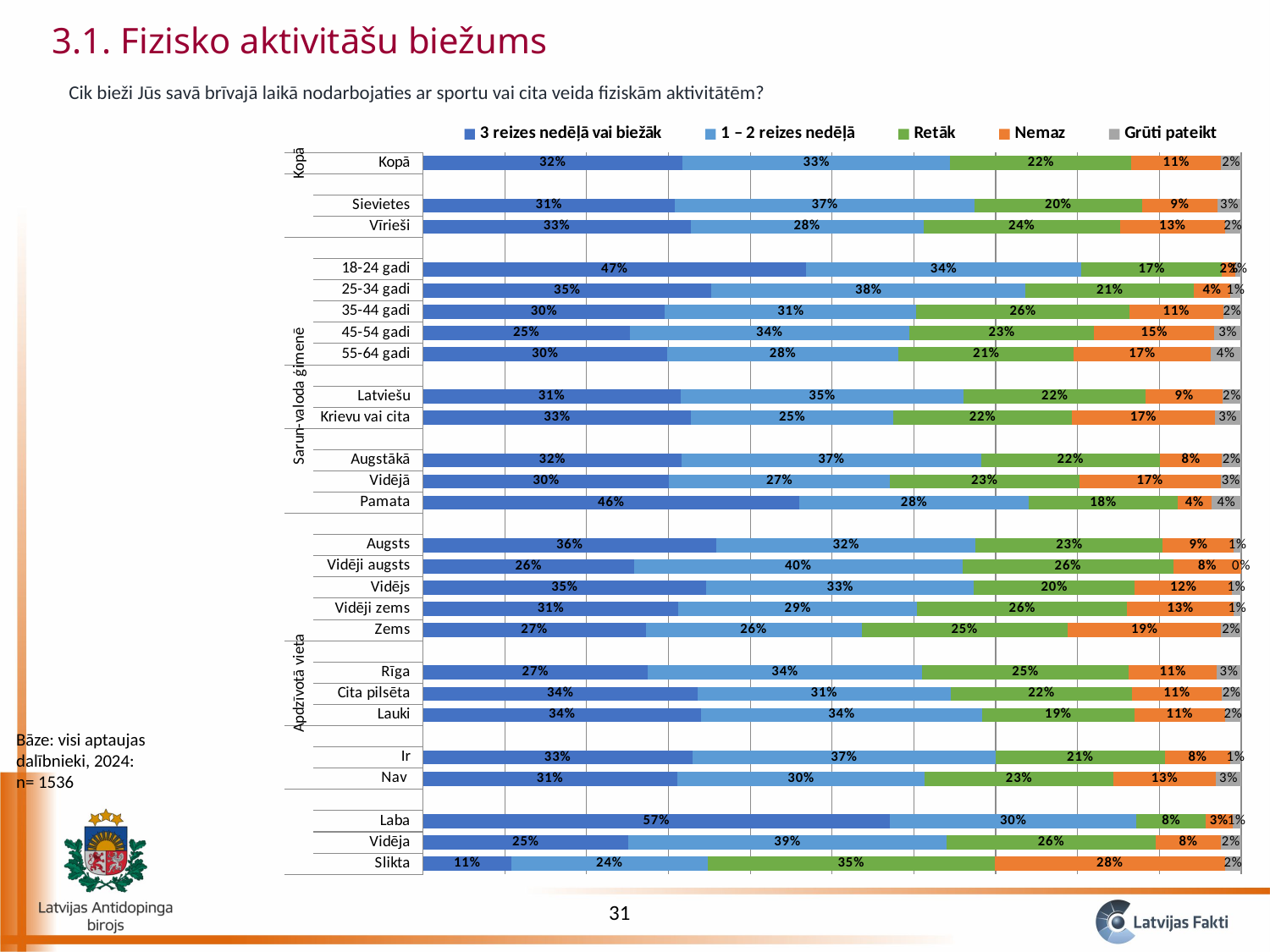
What is the "Retāk" value for the "Pamata" category? 18% Which has a larger "3 reizes nedēļā vai biežāk" value, "Rīga" or "Lauki"? Lauki What is the total of the stacked bar for "Kopā"? 100% How many series does the legend list? 5 What is the difference in percentage points between "Sievietes" and "Vīrieši" for "1 – 2 reizes nedēļā"? 9 percentage points What is the "Nemaz" value for the "Slikta" category? 28% What percentage of the "Kopā" group answered "3 reizes nedēļā vai biežāk"? 32% Which colour represents the "Nemaz" series in the legend? Orange Which category has the lowest "3 reizes nedēļā vai biežāk" value? Slikta What kind of chart is shown on the slide? Stacked bar chart Which category has the highest "3 reizes nedēļā vai biežāk" value? Laba What is the "1 – 2 reizes nedēļā" value for "Vidēji augsts"? 40%